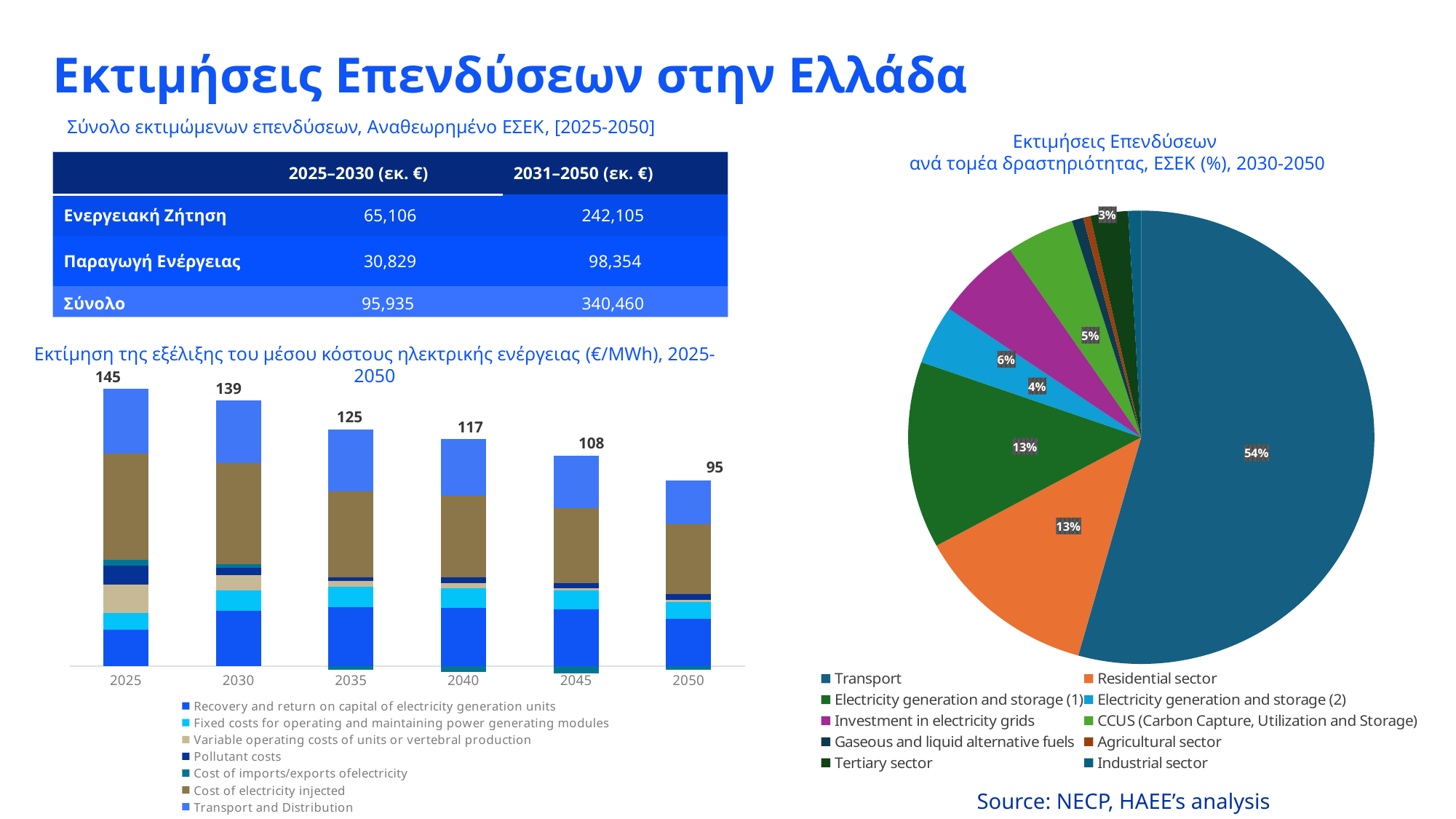
In the bar chart of average electricity cost (€/MWh), what is the total value for 2040? 117 In the bar chart of average electricity cost (€/MWh), do the totals rise or fall from 2025 to 2050? fall In the bar chart of average electricity cost (€/MWh), what is the total value for 2025? 145 In the bar chart of average electricity cost (€/MWh), what is the difference between the 2025 total and the 2050 total? 50 In the bar chart of average electricity cost (€/MWh), which year has the lowest total? 2050 In the pie chart of investment estimates by sector (2030-2050), which sector has the largest slice? Transport How many years are shown on the x axis of the bar chart of average electricity cost (€/MWh)? 6 In the pie chart of investment estimates by sector (2030-2050), what share does Investment in electricity grids have? 6% In the bar chart of average electricity cost (€/MWh), which year has the highest total? 2025 In the pie chart of investment estimates by sector (2030-2050), what share does Transport have? 54% In the bar chart of average electricity cost (€/MWh), what is the total value for 2050? 95 How many series does the legend of the bar chart of average electricity cost (€/MWh) list? 7